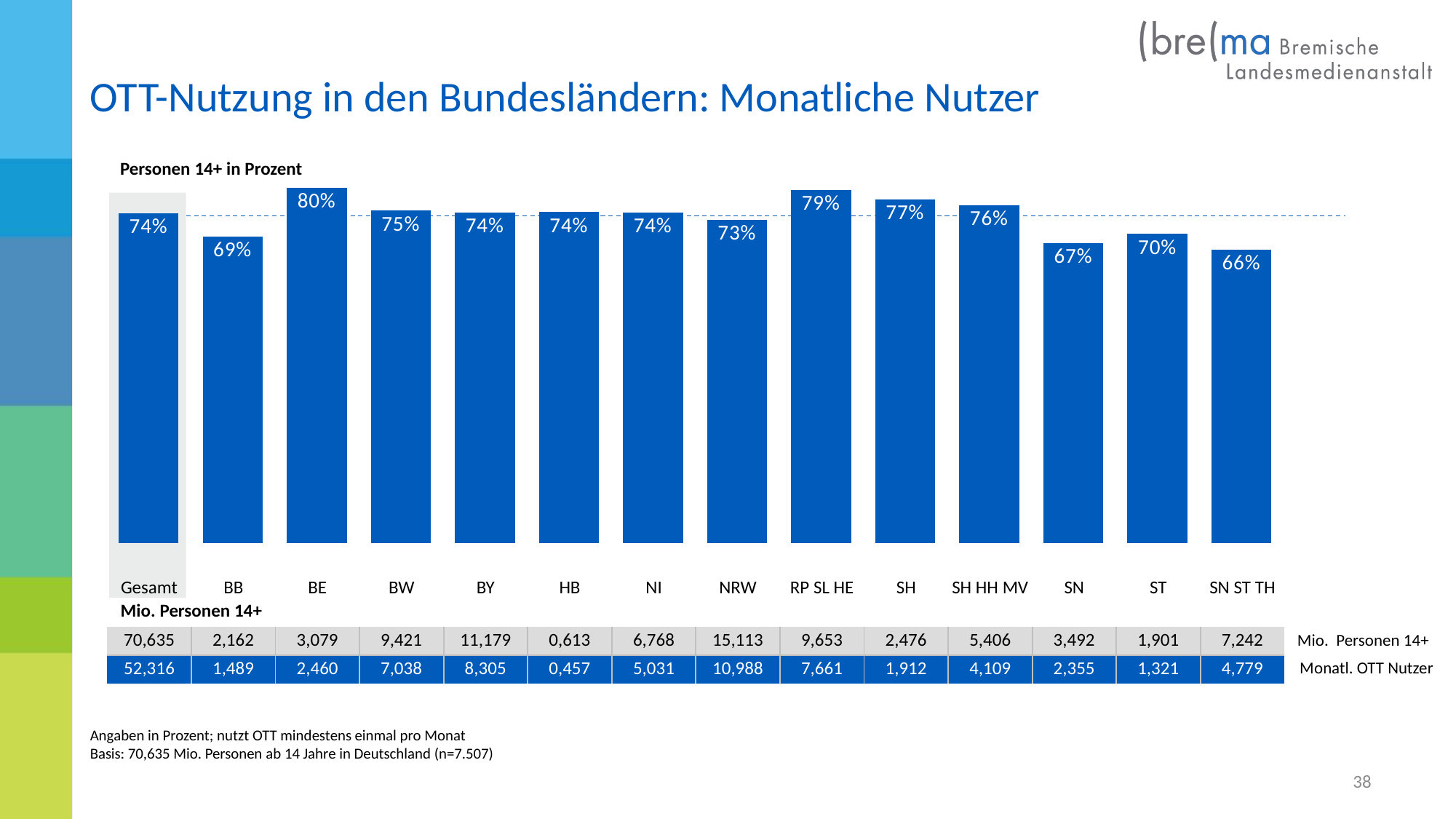
What is the value for SN ST TH? 66% How many categories are shown on the x axis? 14 Which category has the lowest value? SN ST TH Which is larger, the value for SH or the value for SN? SH Which category has the highest value? BE What is the value for Gesamt? 74% What is the value for BE? 80% What is the value for RP SL HE? 79% What is the title of the slide? OTT-Nutzung in den Bundesländern: Monatliche Nutzer What is the difference between the values for SH HH MV and ST? 6% What is the difference between the values for BE and BB? 11% What kind of chart is shown on the slide? bar chart